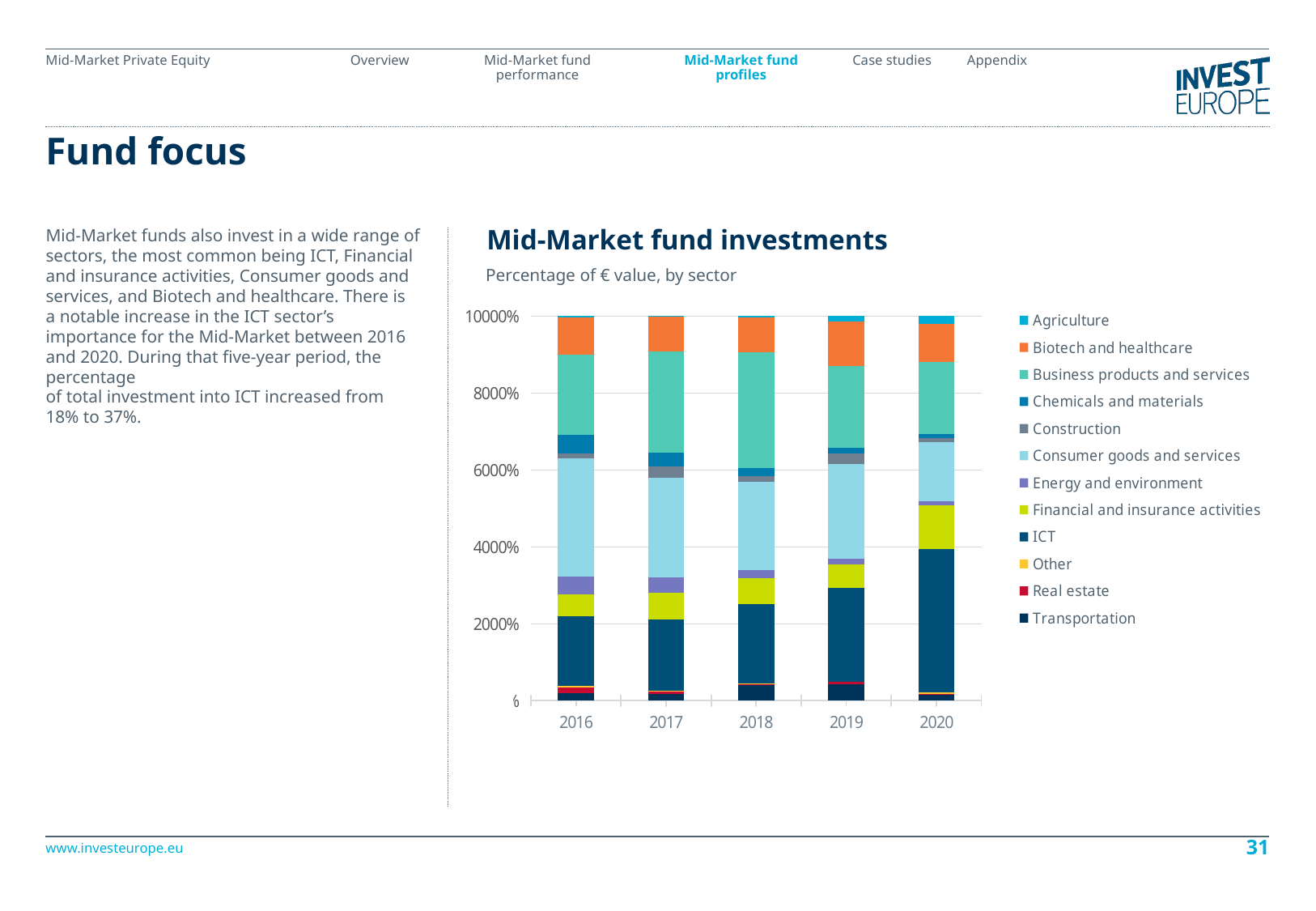
Does the ICT segment rise or fall from 2016 to 2020? rise Is the Consumer goods and services segment larger in 2016 or in 2020? 2016 What kind of chart is shown on the slide? Stacked bar chart Is the ICT segment larger in 2016 or in 2020? 2020 Is the value for ICT in 2020 greater or less than 2000%? greater What is the title of the chart? Mid-Market fund investments Which year has the smallest Consumer goods and services segment in the chart? 2020 How many sectors does the chart's legend list? 12 How many years are shown on the x axis of the chart? 5 What does the chart's subtitle say is being measured? Percentage of € value, by sector Which year has the largest ICT segment in the chart? 2020 Is the value for Biotech and healthcare in 2020 greater or less than 2000%? less